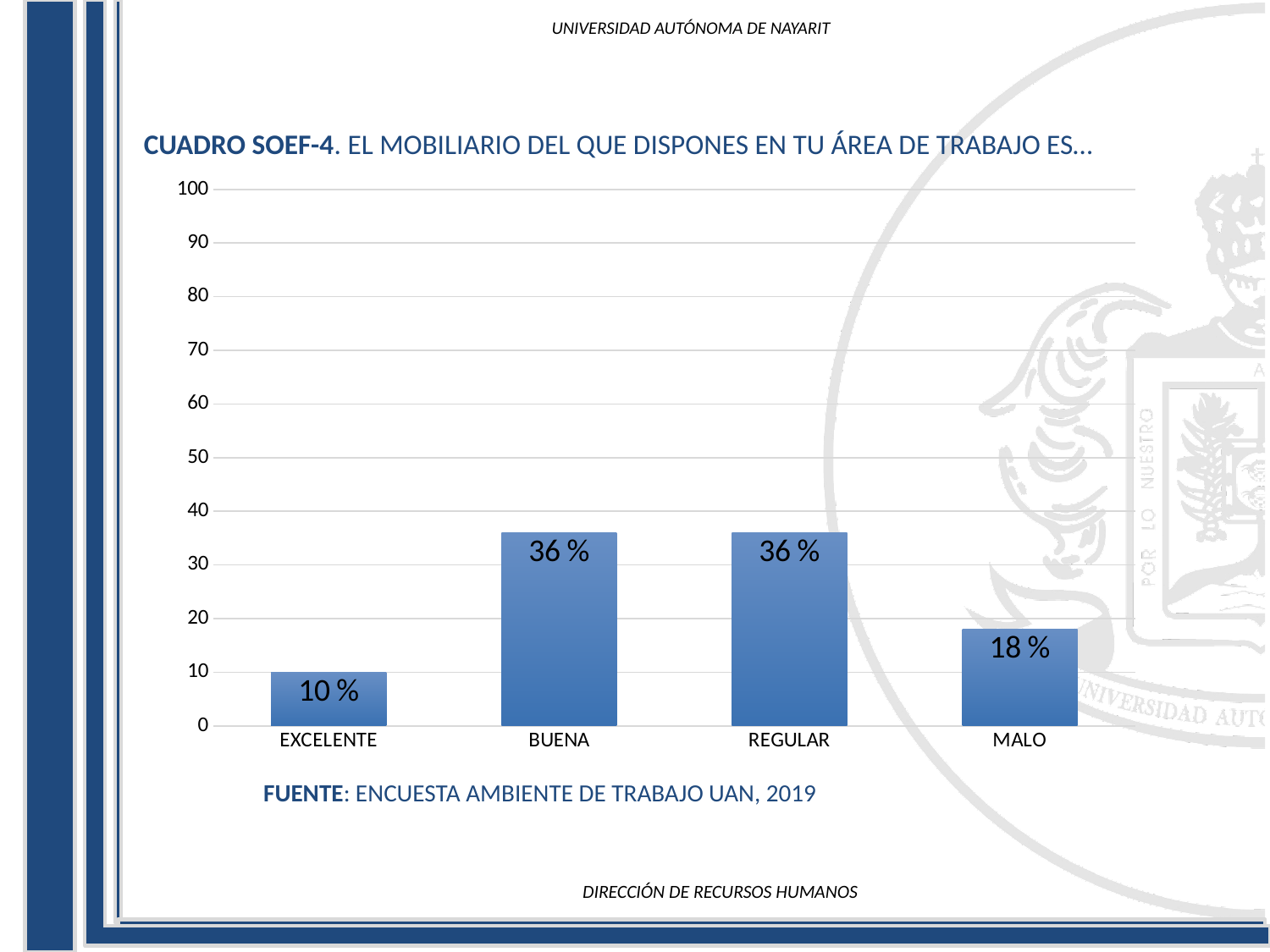
What is the source cited below the chart? ENCUESTA AMBIENTE DE TRABAJO UAN, 2019 Which is larger, the value for BUENA or the value for MALO? BUENA What is the highest value shown on the y axis? 100 What is the value for EXCELENTE? 10 % What is the difference between the values for MALO and EXCELENTE? 8 % What is the difference between the values for REGULAR and MALO? 18 % Which category has the lowest value? EXCELENTE Is the value for REGULAR greater or less than 30? greater What kind of chart is shown on the slide? bar chart What is the value for MALO? 18 % What is the value for BUENA? 36 % How many categories are shown on the x axis? 4